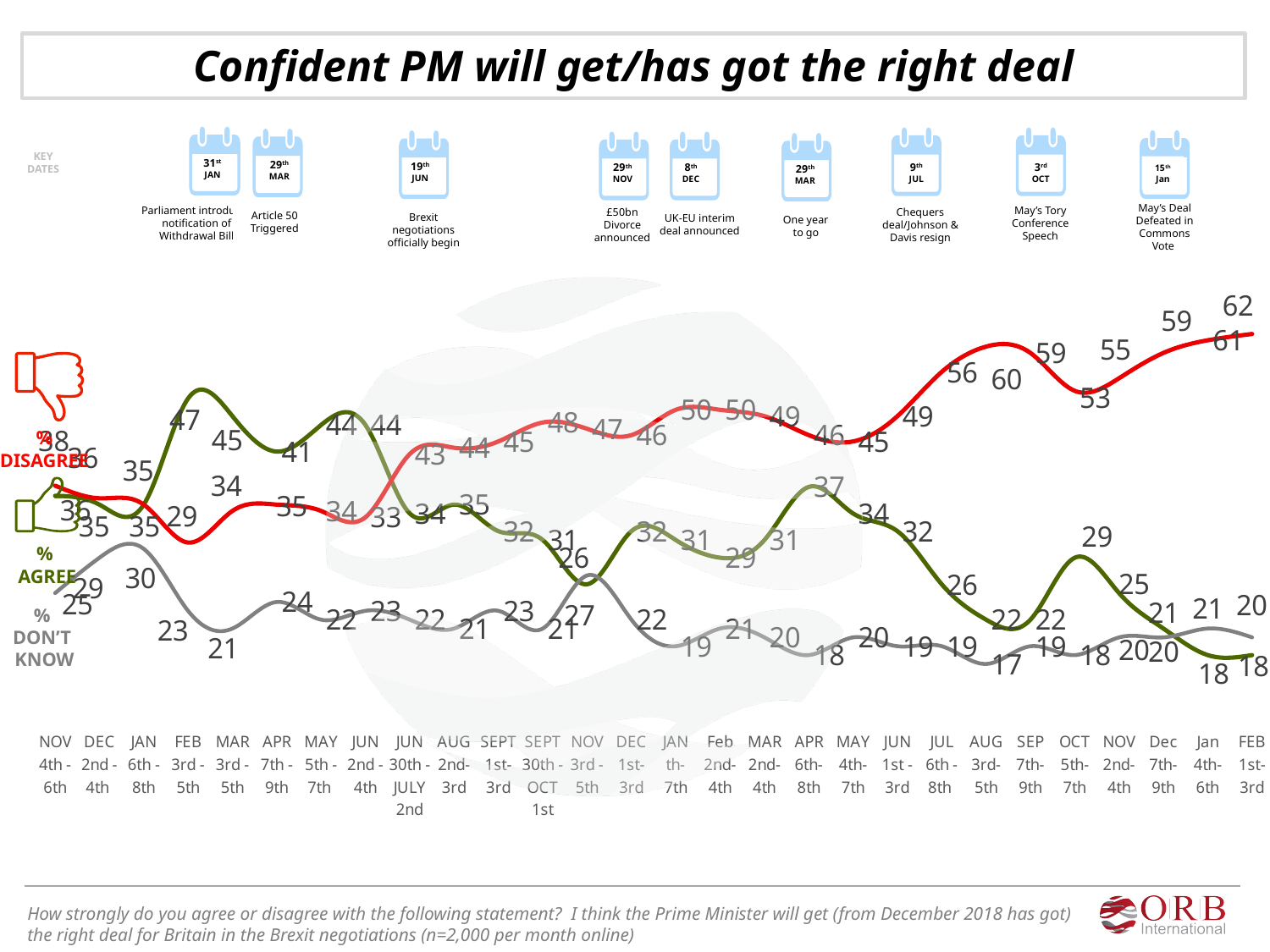
What is the highest value reached by the % AGREE line? 47 What is the highest value on the % DISAGREE line? 62 What is the lowest value on the % DON'T KNOW line? 17 What are the three series shown on the chart? % DISAGREE, % AGREE, % DON'T KNOW Does the % DISAGREE line generally rise or fall from the first point to the last point on the x axis? rise What kind of chart is shown on the slide? line chart What is the % DISAGREE value for FEB 3rd-5th (the fourth point on the x axis)? 29 At FEB 3rd-5th (the fourth point), what is the difference between % AGREE (47) and % DISAGREE (29)? 18 How many series are plotted on the chart? 3 At the last point on the x axis (FEB 1st-3rd), which is higher, % DISAGREE or % AGREE? % DISAGREE What is the % AGREE value for FEB 3rd-5th (the fourth point on the x axis)? 47 What is the title of the chart? Confident PM will get/has got the right deal